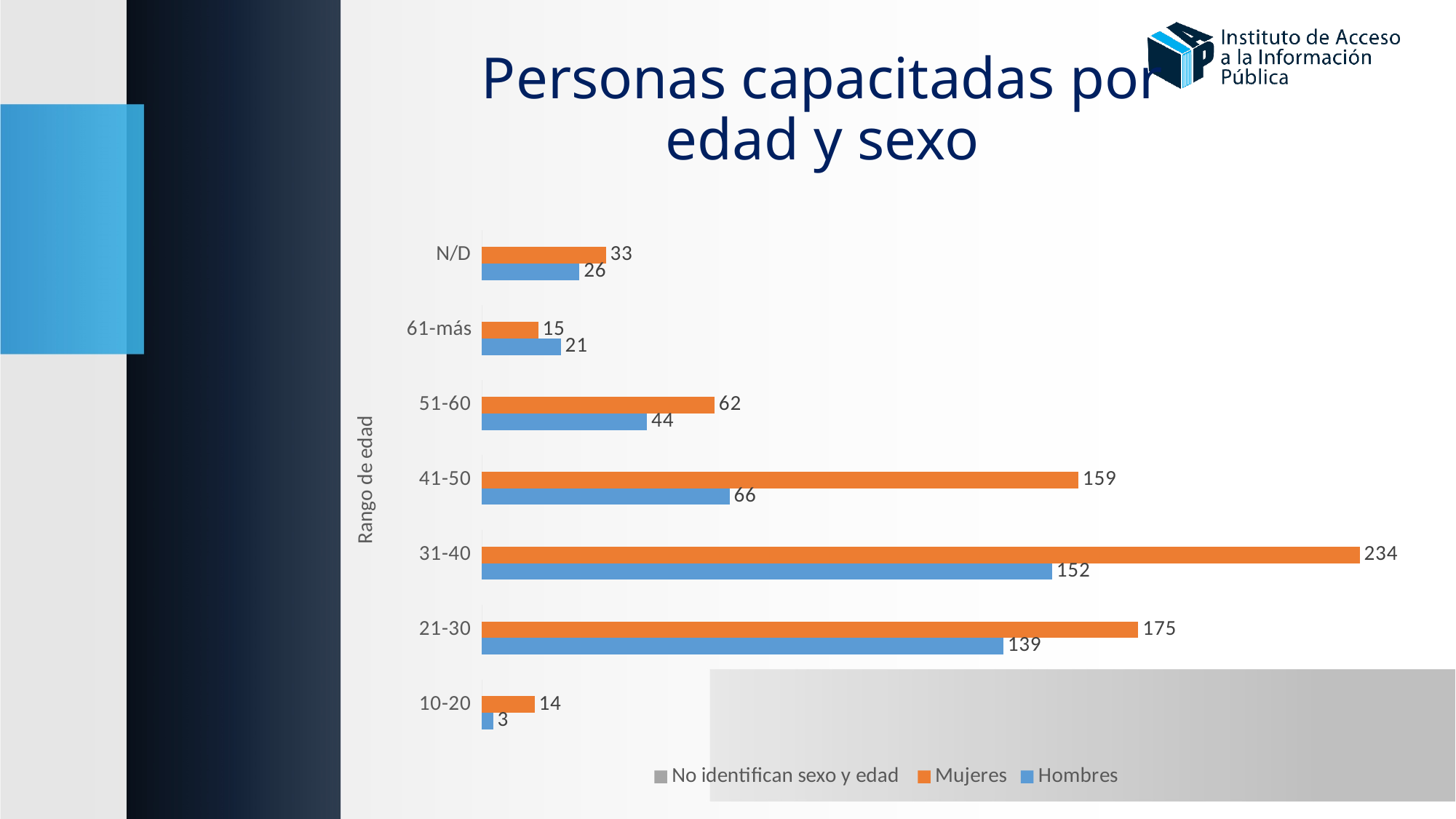
Which is larger in the 61-más age range, Mujeres or Hombres? Hombres What is the value for Mujeres in the 51-60 age range? 62 What is the value for Hombres in the 21-30 age range? 139 Which age range has the highest value for Mujeres? 31-40 What is the difference between Mujeres and Hombres in the 41-50 age range? 93 What is the value for Hombres in the 10-20 age range? 3 What is the value for Mujeres in the 31-40 age range? 234 What kind of chart is shown on the slide? Bar chart How many age range categories are shown on the chart? 7 Which age range has the lowest value for Hombres? 10-20 What is the title of the chart? Personas capacitadas por edad y sexo How many series does the legend list? 3